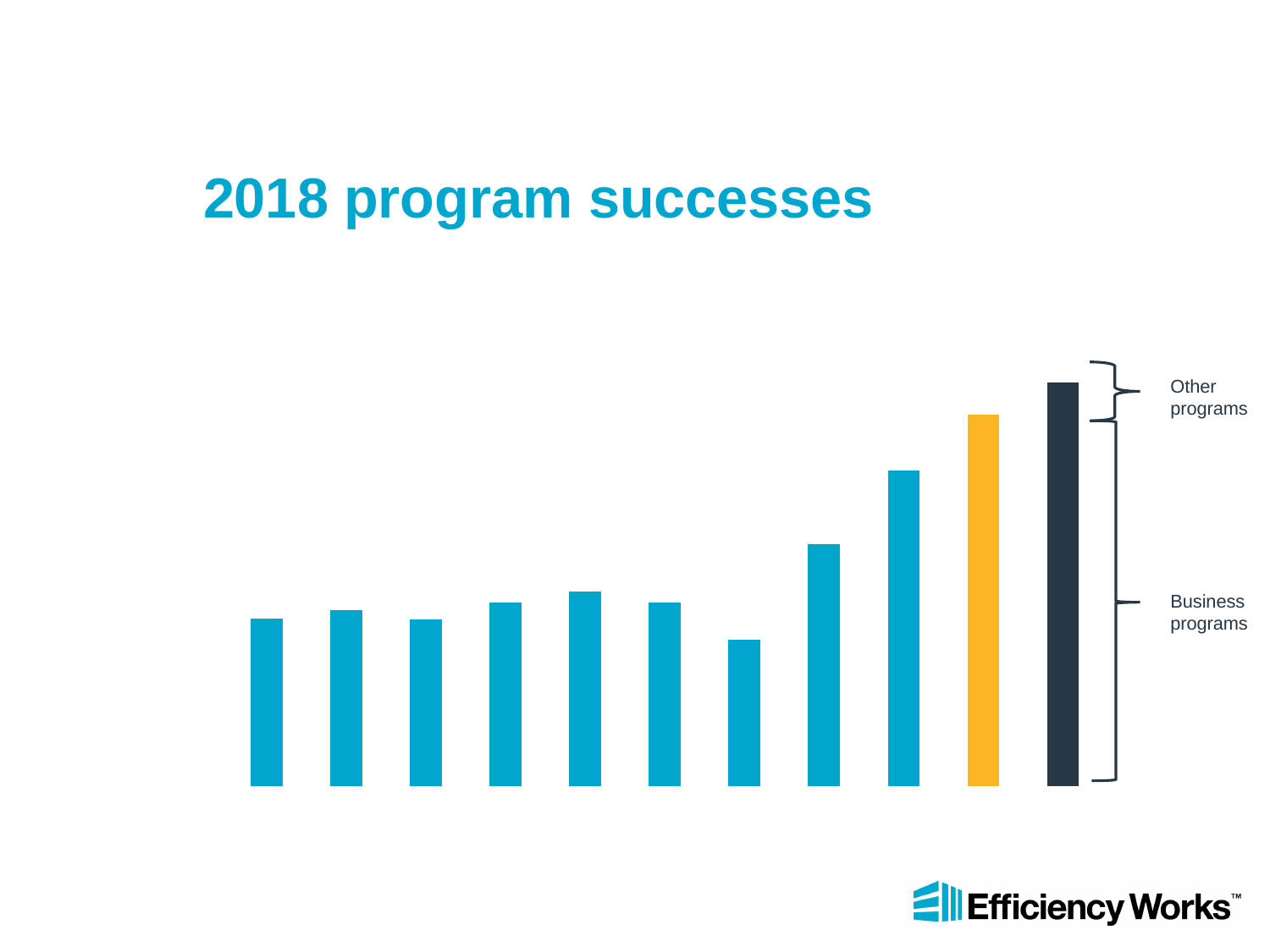
Is the rightmost bar taller or shorter than the leftmost bar? taller Is the orange bar taller or shorter than the dark bar to its right? shorter What kind of chart is shown on the slide? bar chart What is the title of the slide containing the chart? 2018 program successes Which bar is the shortest in the chart? the seventh bar from the left How many bars are plotted in the chart? 11 Which bar is the tallest in the chart? the rightmost (dark) bar What two labels are shown next to the brackets on the rightmost bar? Other programs; Business programs Is the third bar from the right taller or shorter than the orange bar? shorter